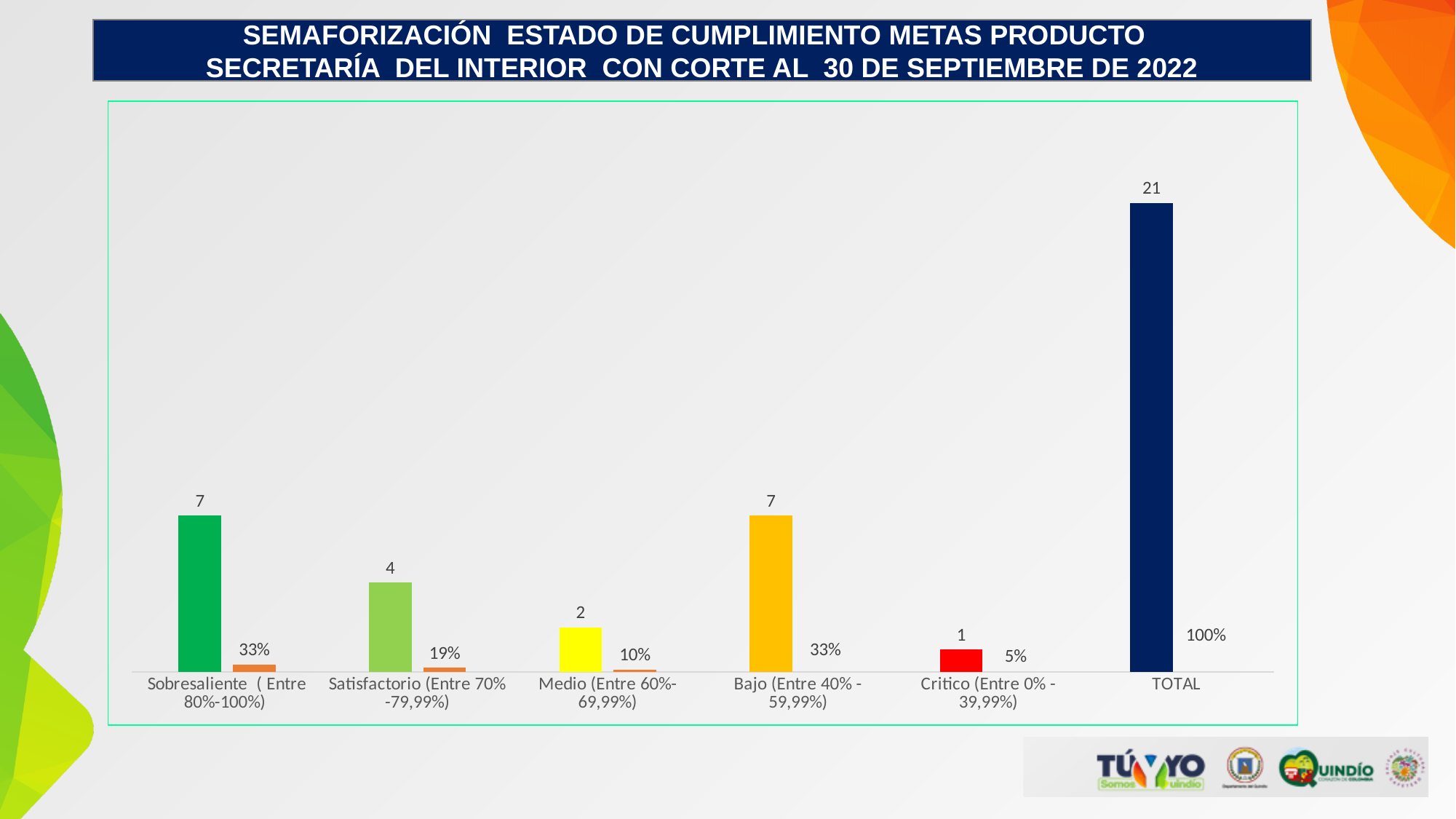
What is the count value shown for the Sobresaliente (Entre 80%-100%) category? 7 Which has a larger count, Satisfactorio (Entre 70%-79,99%) or Critico (Entre 0%-39,99%)? Satisfactorio (Entre 70%-79,99%) What percentage is shown for the Medio (Entre 60%-69,99%) category? 10% What is the count value shown for the Satisfactorio (Entre 70%-79,99%) category? 4 What colour is the bar for the Bajo (Entre 40%-59,99%) category? Orange Excluding the TOTAL bar, which category has the lowest count? Critico (Entre 0%-39,99%) Which bar is the tallest in the chart? TOTAL What is the value shown for the TOTAL bar? 21 What is the difference between the count for Bajo (Entre 40%-59,99%) and the count for Medio (Entre 60%-69,99%)? 5 What percentage is shown for the Critico (Entre 0%-39,99%) category? 5% What kind of chart is shown on the slide? Bar chart How many categories are shown on the x axis of the chart? 6